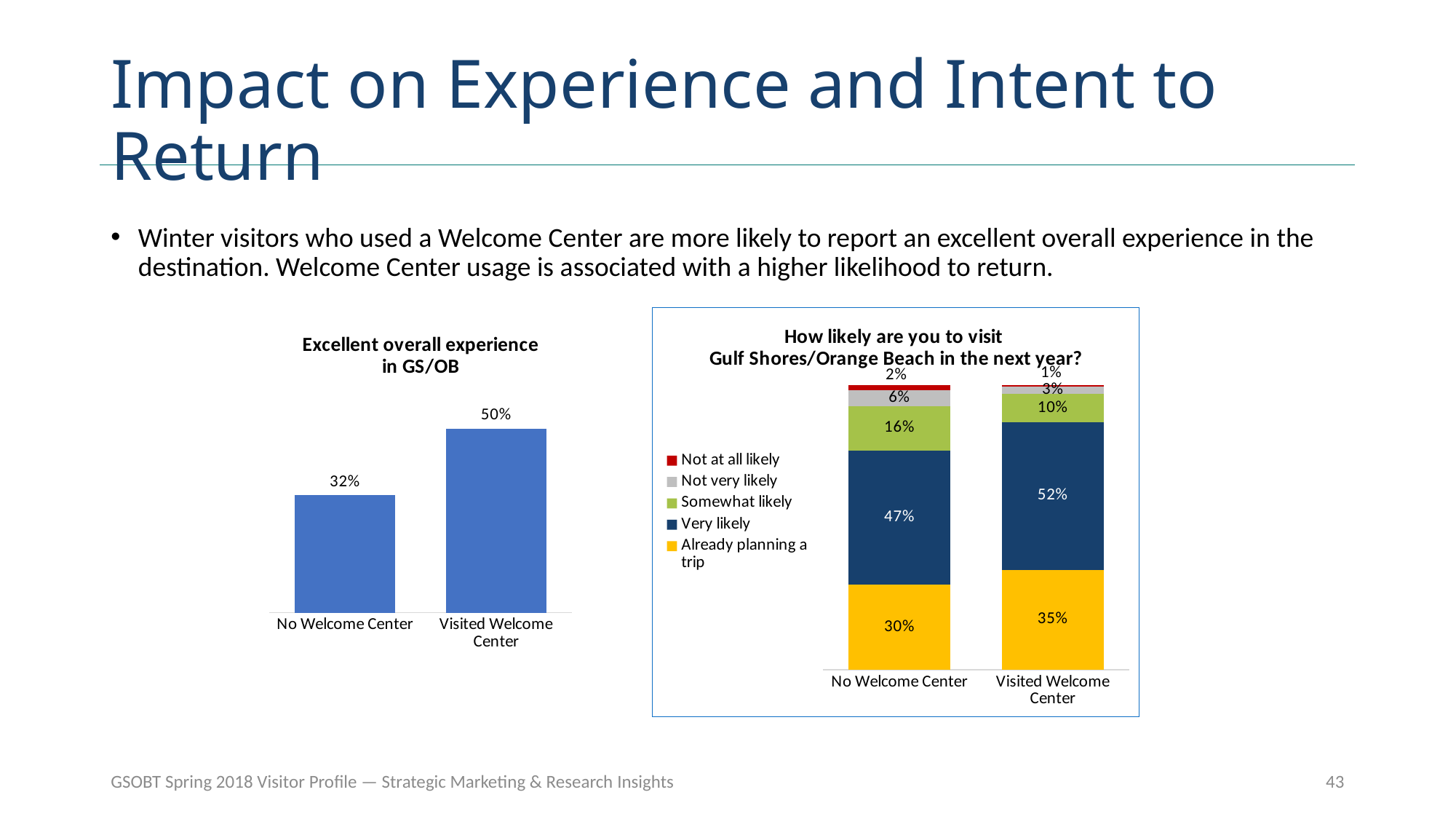
In the 'How likely are you to visit Gulf Shores/Orange Beach in the next year?' chart, what is the difference between the Somewhat likely values for No Welcome Center and Visited Welcome Center? 6% In the 'Excellent overall experience in GS/OB' chart, what is the value for Visited Welcome Center? 50% What kind of chart is the 'Excellent overall experience in GS/OB' chart? Bar chart In the 'How likely are you to visit Gulf Shores/Orange Beach in the next year?' chart, how many series does the legend list? 5 In the 'How likely are you to visit Gulf Shores/Orange Beach in the next year?' chart, what is the Not at all likely value for Visited Welcome Center? 1% In the 'How likely are you to visit Gulf Shores/Orange Beach in the next year?' chart, what is the Already planning a trip value for No Welcome Center? 30% In the 'How likely are you to visit Gulf Shores/Orange Beach in the next year?' chart, what is the Very likely value for Visited Welcome Center? 52% In the 'How likely are you to visit Gulf Shores/Orange Beach in the next year?' chart, which group has the larger Already planning a trip value, No Welcome Center or Visited Welcome Center? Visited Welcome Center In the 'Excellent overall experience in GS/OB' chart, what is the difference between Visited Welcome Center and No Welcome Center? 18% In the 'How likely are you to visit Gulf Shores/Orange Beach in the next year?' chart, what is the Somewhat likely value for No Welcome Center? 16% In the 'Excellent overall experience in GS/OB' chart, which category has the higher value? Visited Welcome Center In the 'Excellent overall experience in GS/OB' chart, what is the value for No Welcome Center? 32%